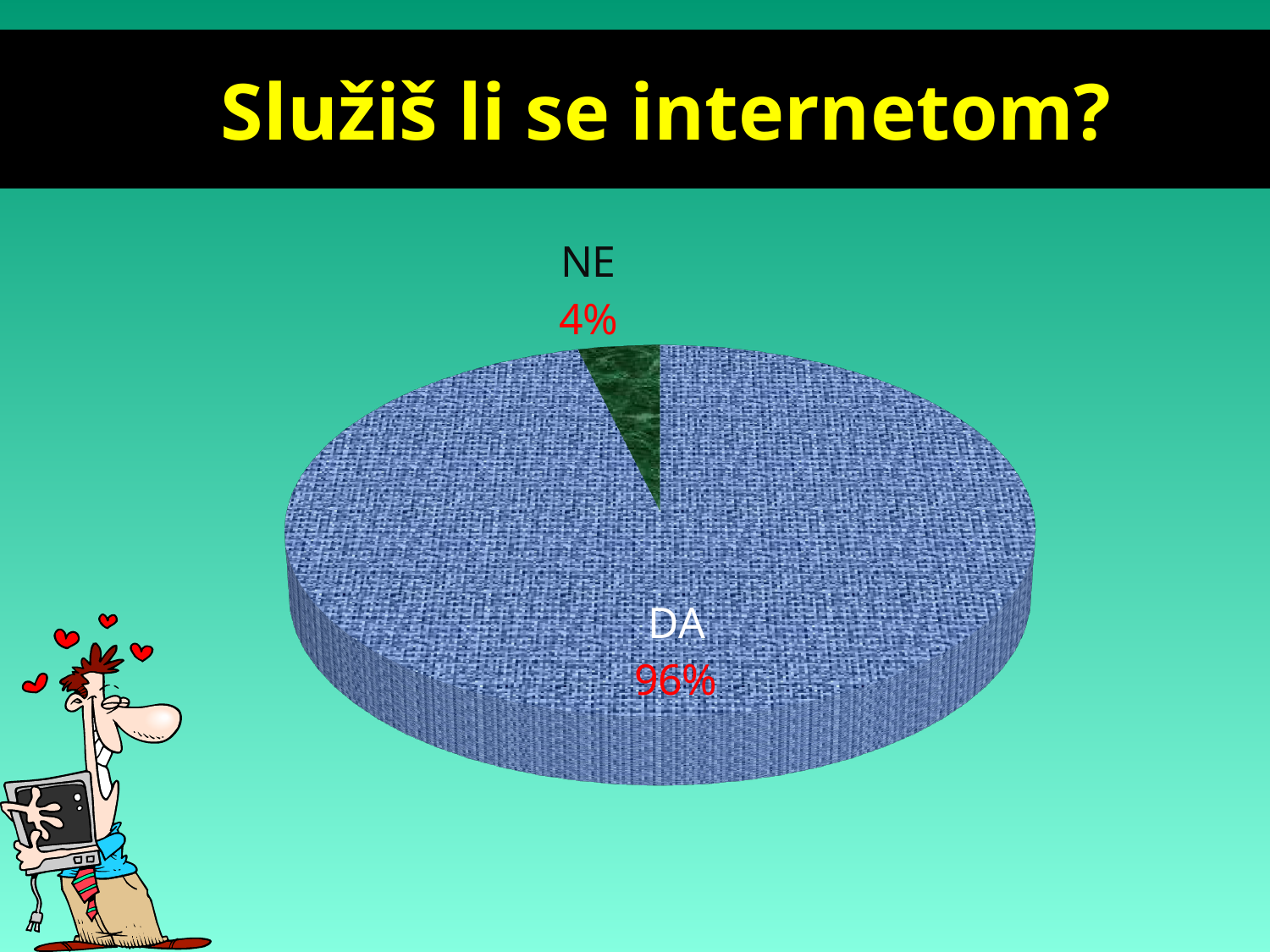
What percentage of the pie is labelled NE? 4% What percentage of the pie is labelled DA? 96% What share of the pie does the DA slice represent? 96% Which slice is larger, DA or NE? DA What is the difference in percentage points between the DA and NE slices? 92 What is the title of the slide containing the pie chart? Služiš li se internetom? How many slices does the pie chart have? 2 What kind of chart is shown on the slide? pie chart What colour is the NE slice of the pie? green Which slice of the pie is the smallest? NE Which slice of the pie is the largest? DA